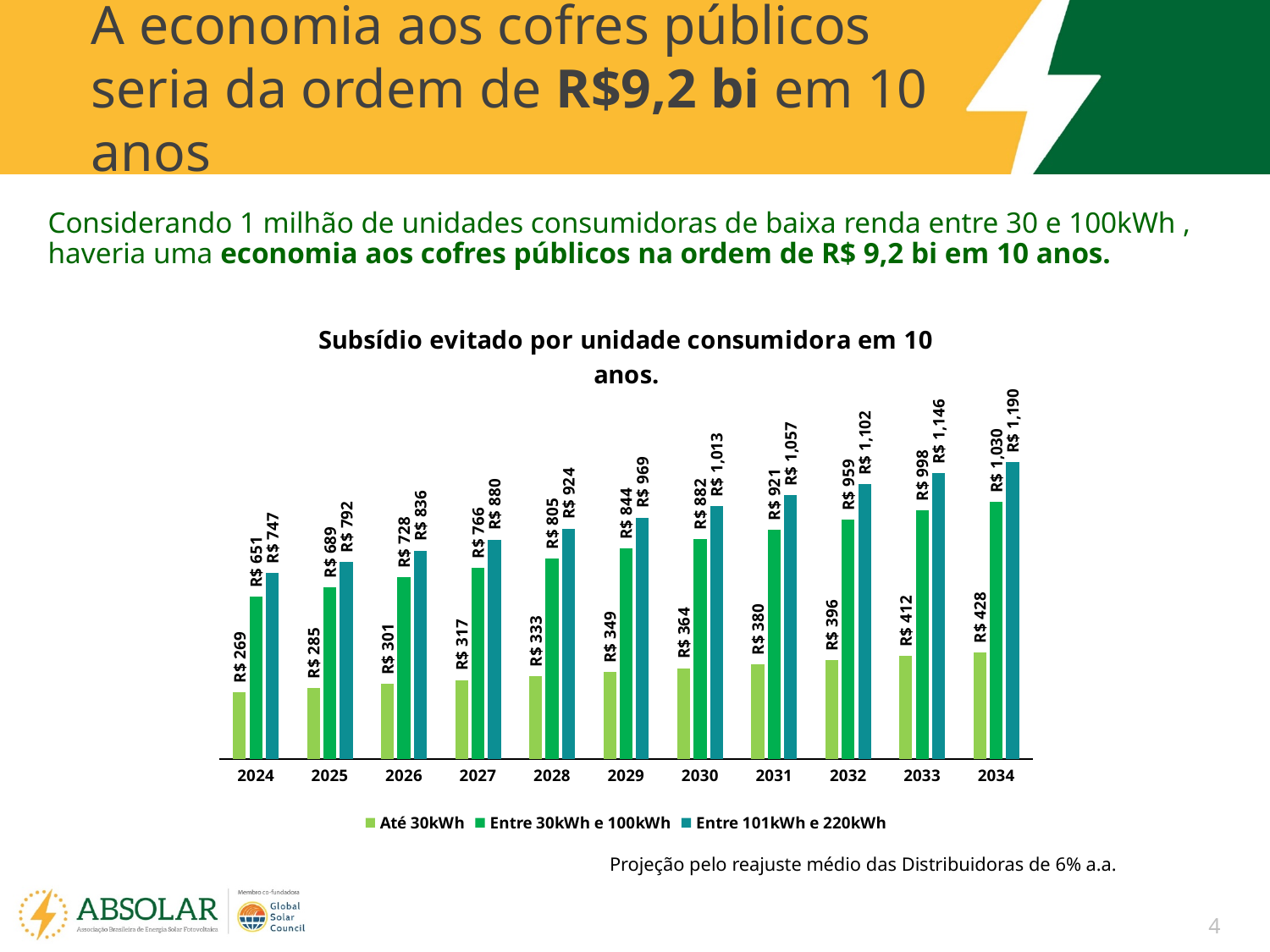
What is the title of the chart? Subsídio evitado por unidade consumidora em 10 anos. What is the value for 'Entre 30kWh e 100kWh' in 2029? R$ 844 What kind of chart is shown? Bar chart What is the value for 'Até 30kWh' in 2024? R$ 269 Do the values for 'Até 30kWh' rise or fall from 2024 to 2034? Rise What is the value for 'Entre 101kWh e 220kWh' in 2034? R$ 1,190 How many years are shown on the x axis? 11 Which is larger in 2027: 'Entre 30kWh e 100kWh' or 'Entre 101kWh e 220kWh'? Entre 101kWh e 220kWh How many series does the legend list? 3 Which year has the highest value for 'Entre 30kWh e 100kWh'? 2034 What is the difference between 'Entre 101kWh e 220kWh' and 'Até 30kWh' in 2030? R$ 649 Which year has the lowest value for 'Até 30kWh'? 2024